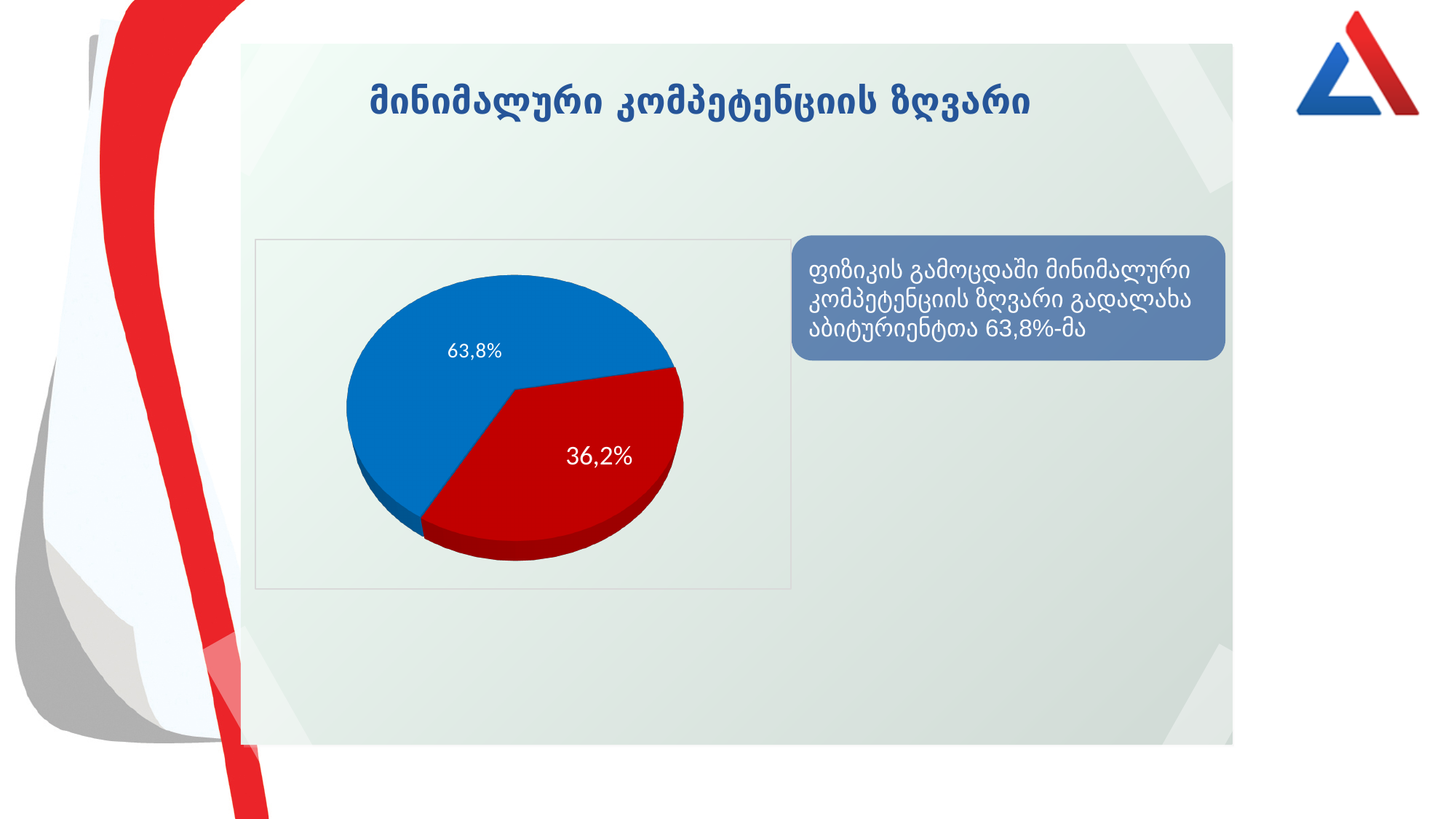
What value is shown on the blue slice of the pie chart? 63,8% What kind of chart is shown on the slide? pie chart Which is larger, the blue slice or the red slice? the blue slice What is the difference between the blue slice and the red slice of the pie chart? 27,6% Is the value of the red slice greater or less than 50%? less How many slices does the pie chart have? 2 What two colours are used for the slices of the pie chart? blue and red Which slice of the pie chart is the largest? the blue slice (63,8%) What is the title of the slide containing the pie chart? მინიმალური კომპეტენციის ზღვარი What value is shown on the red slice of the pie chart? 36,2% What share of the pie does the blue slice represent? 63,8% Which slice of the pie chart is the smallest? the red slice (36,2%)